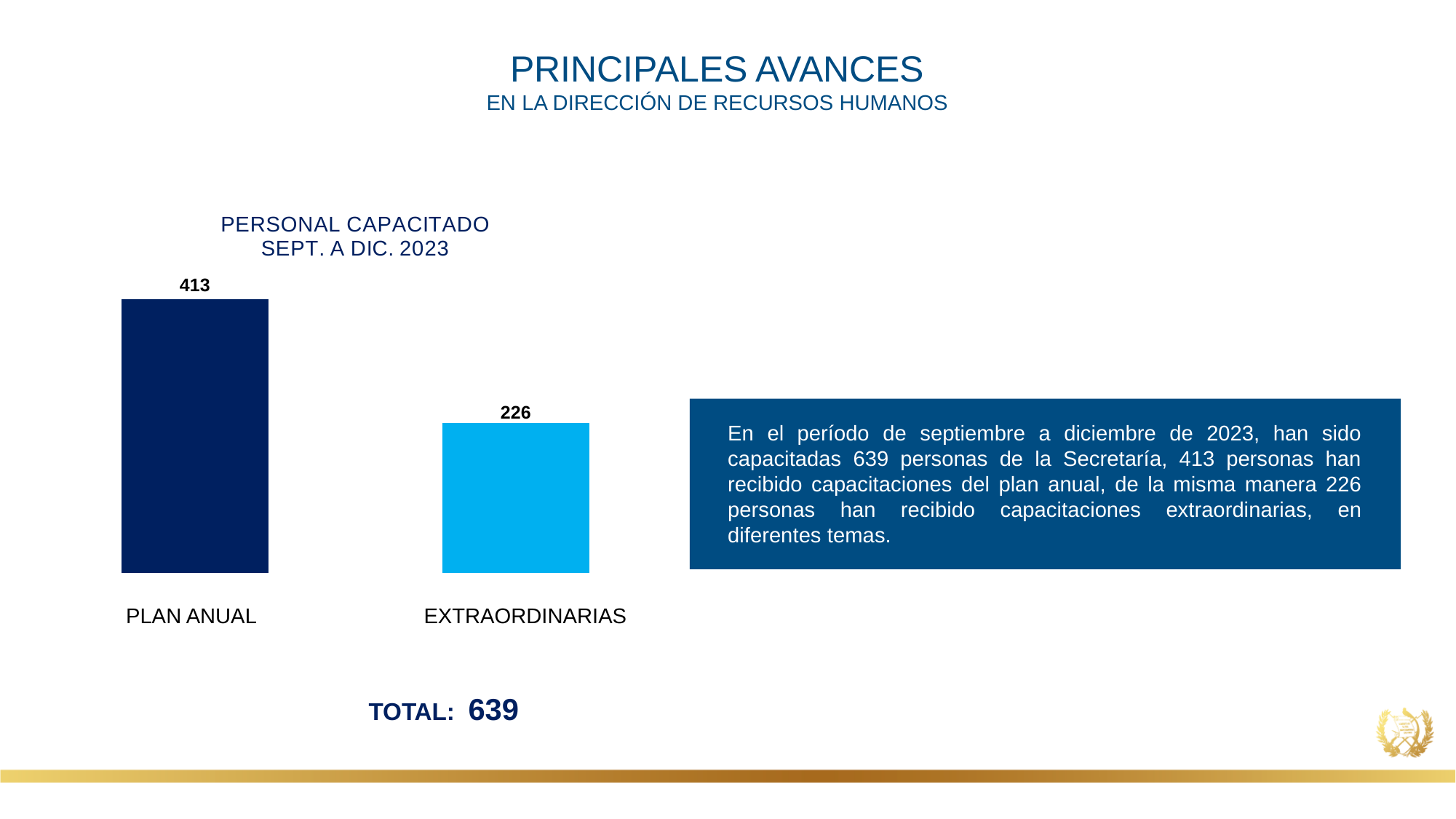
What is the value for PLAN ANUAL? 413 What kind of chart is shown on the slide? bar chart What is the total of the two values shown in the chart? 639 What colour is the bar for EXTRAORDINARIAS? light blue What is the title of the chart? PERSONAL CAPACITADO SEPT. A DIC. 2023 Which category has the lowest value? EXTRAORDINARIAS Which category has the highest value? PLAN ANUAL What is the difference between the values for PLAN ANUAL and EXTRAORDINARIAS? 187 Which is larger, the value for PLAN ANUAL or the value for EXTRAORDINARIAS? PLAN ANUAL What is the value for EXTRAORDINARIAS? 226 How many categories are shown in the chart? 2